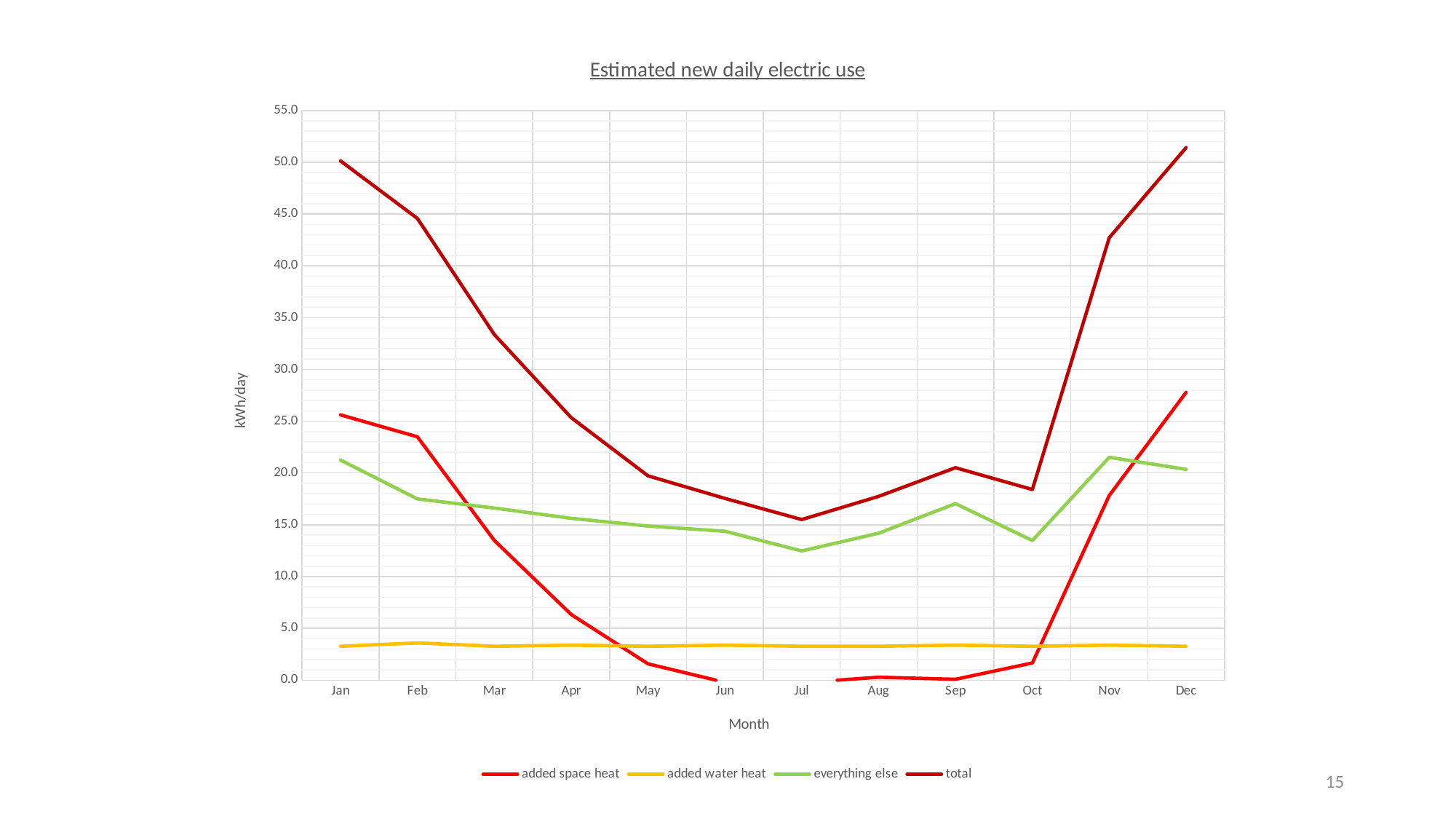
How many series does the legend list? 4 Is the value for everything else in Nov greater or less than 20.0? greater What is the title of the chart? Estimated new daily electric use Which is larger in Mar: added space heat or everything else? everything else Does the total series rise or fall from Jan to May? fall Is the value for added space heat in Apr greater or less than 10.0? less In which month is the total series at its highest? Dec In which month is the everything else series at its lowest? Jul How many months are plotted along the x axis? 12 What kind of chart is shown on the slide? line chart Is the value for total in Jan greater or less than 45.0? greater In which month is the total series at its lowest? Jul